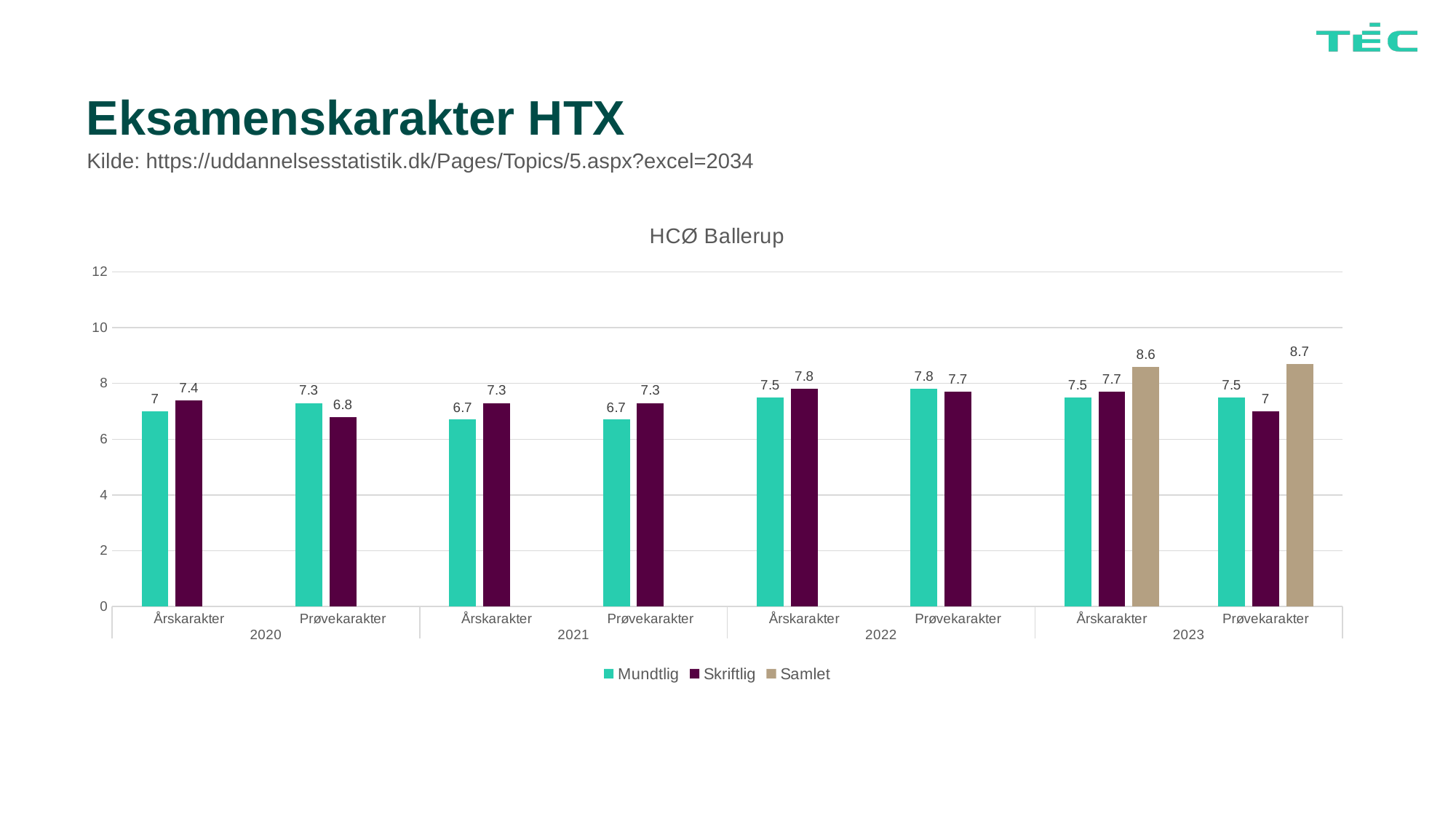
What is the Mundtlig value for Årskarakter in 2020? 7 What is the lowest Mundtlig value shown in the chart? 6.7 What is the title of the chart? HCØ Ballerup Which bar has the highest value in the chart? Samlet, Prøvekarakter 2023 What kind of chart is shown on the slide? Bar chart Which is larger for Prøvekarakter in 2020: Mundtlig or Skriftlig? Mundtlig Is the Samlet value for Årskarakter 2023 greater or less than 8? greater What is the Skriftlig value for Årskarakter in 2022? 7.8 What is the difference between the Samlet value for Prøvekarakter 2023 and the Skriftlig value for Prøvekarakter 2023? 1.7 What is the Skriftlig value for Prøvekarakter in 2021? 7.3 How many series does the legend list? 3 What is the Samlet value for Prøvekarakter in 2023? 8.7